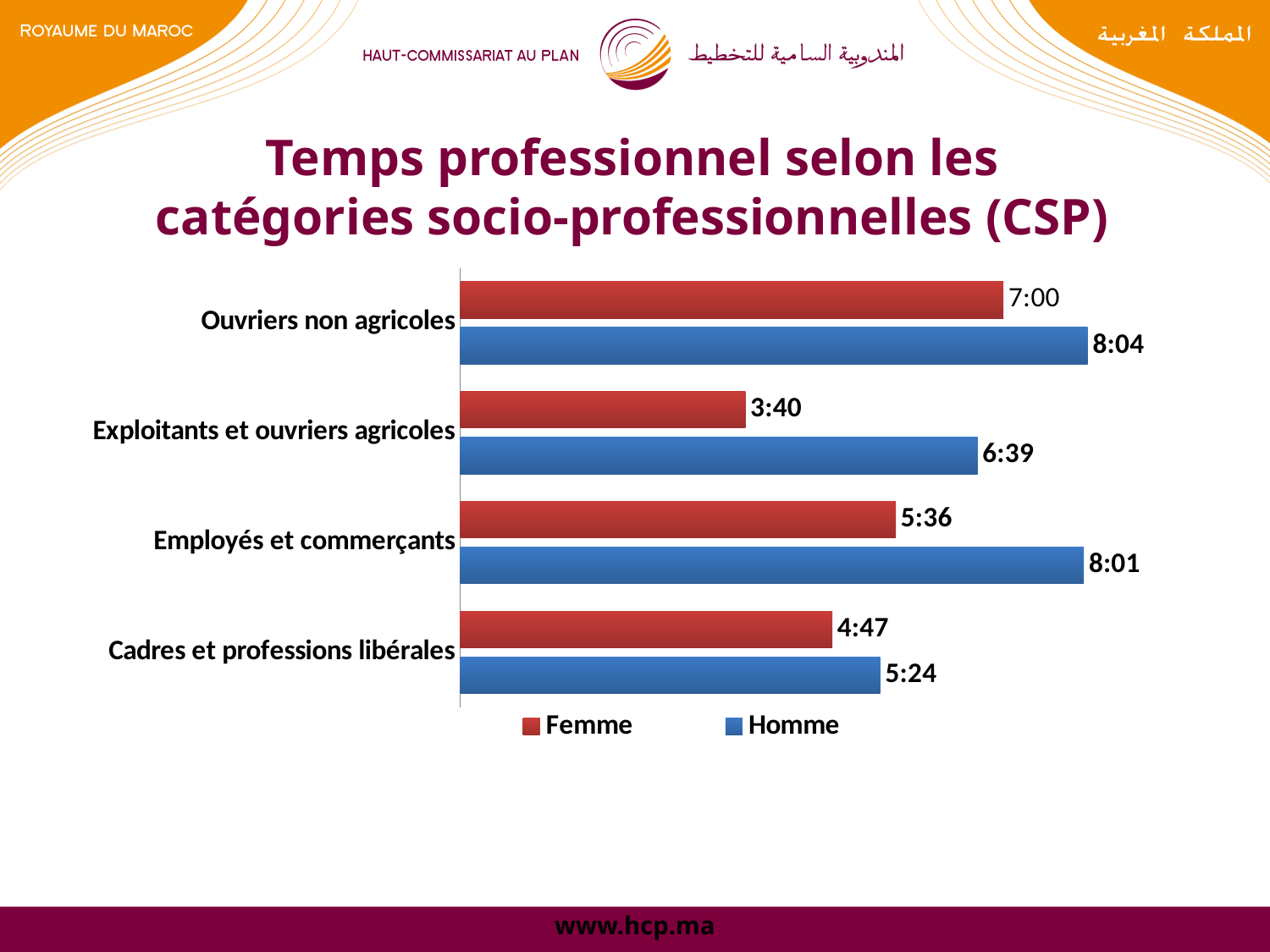
How many series does the legend list? 2 What kind of chart is shown on the slide? Bar chart What is the value for Femme in the Ouvriers non agricoles category? 7:00 What is the value for Homme in the Exploitants et ouvriers agricoles category? 6:39 What is the value for Femme in the Employés et commerçants category? 5:36 What is the value for Homme in the Cadres et professions libérales category? 5:24 What is the difference between the Homme and Femme values for Exploitants et ouvriers agricoles? 2:59 What is the difference between the Homme and Femme values for Cadres et professions libérales? 0:37 Which category has the highest value for Homme? Ouvriers non agricoles How many categories are shown on the chart? 4 Which category has the lowest value for Femme? Exploitants et ouvriers agricoles Which is larger, the Femme value for Ouvriers non agricoles or the Femme value for Employés et commerçants? Ouvriers non agricoles